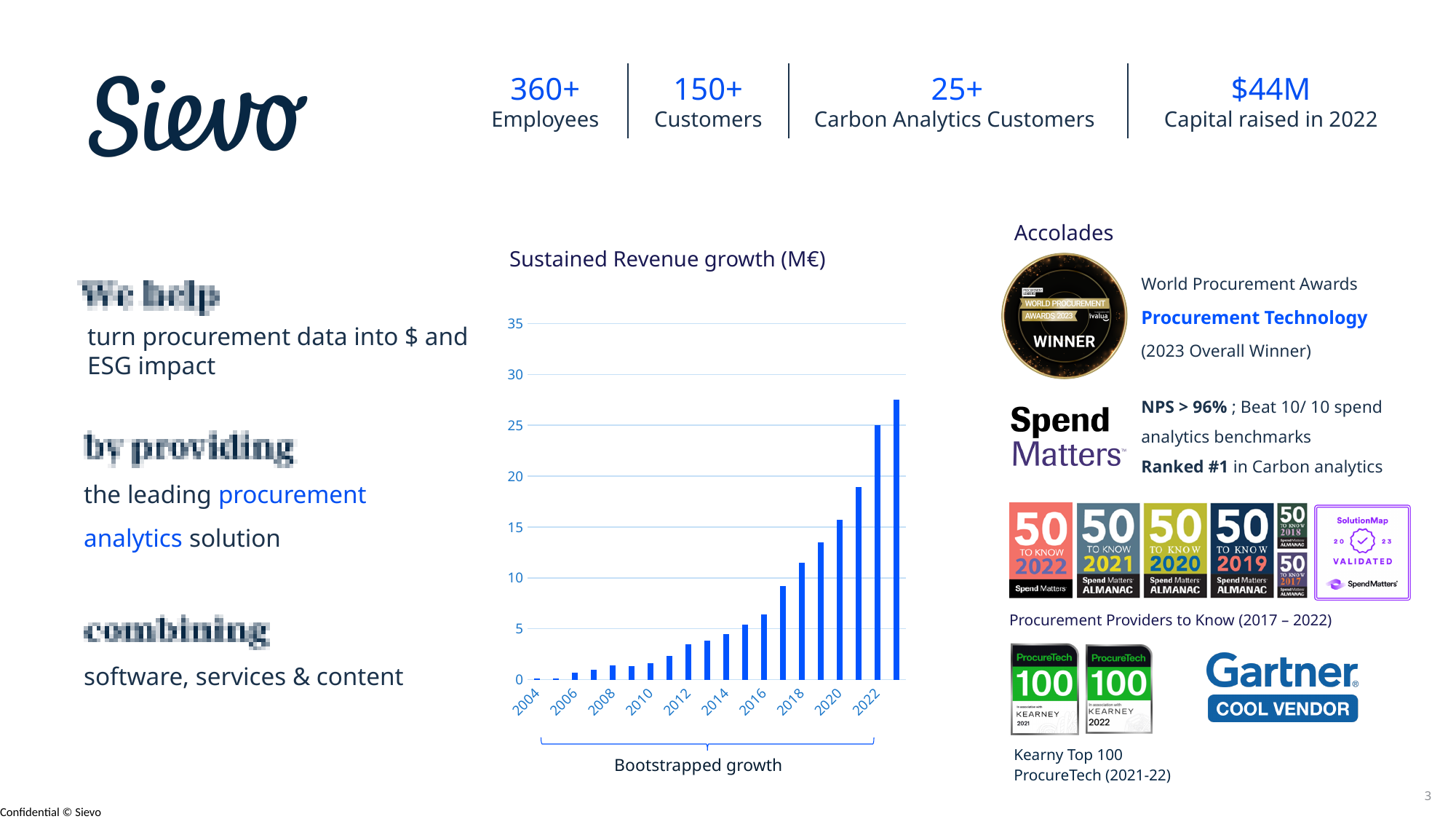
Which year has the larger revenue value, 2018 or 2022? 2022 What is the title of the chart on the slide? Sustained Revenue growth (M€) Is the revenue value for 2010 greater or less than 5? less Which year has the larger revenue value, 2016 or 2020? 2020 Is the revenue value for 2020 greater or less than 15? greater Is the tallest bar in the chart greater or less than 30? less Do the revenue values generally rise or fall from 2004 to the right end of the x axis? rise What label is shown on the bracket beneath the x axis of the chart? Bootstrapped growth What kind of chart is shown under the title "Sustained Revenue growth (M€)"? bar chart